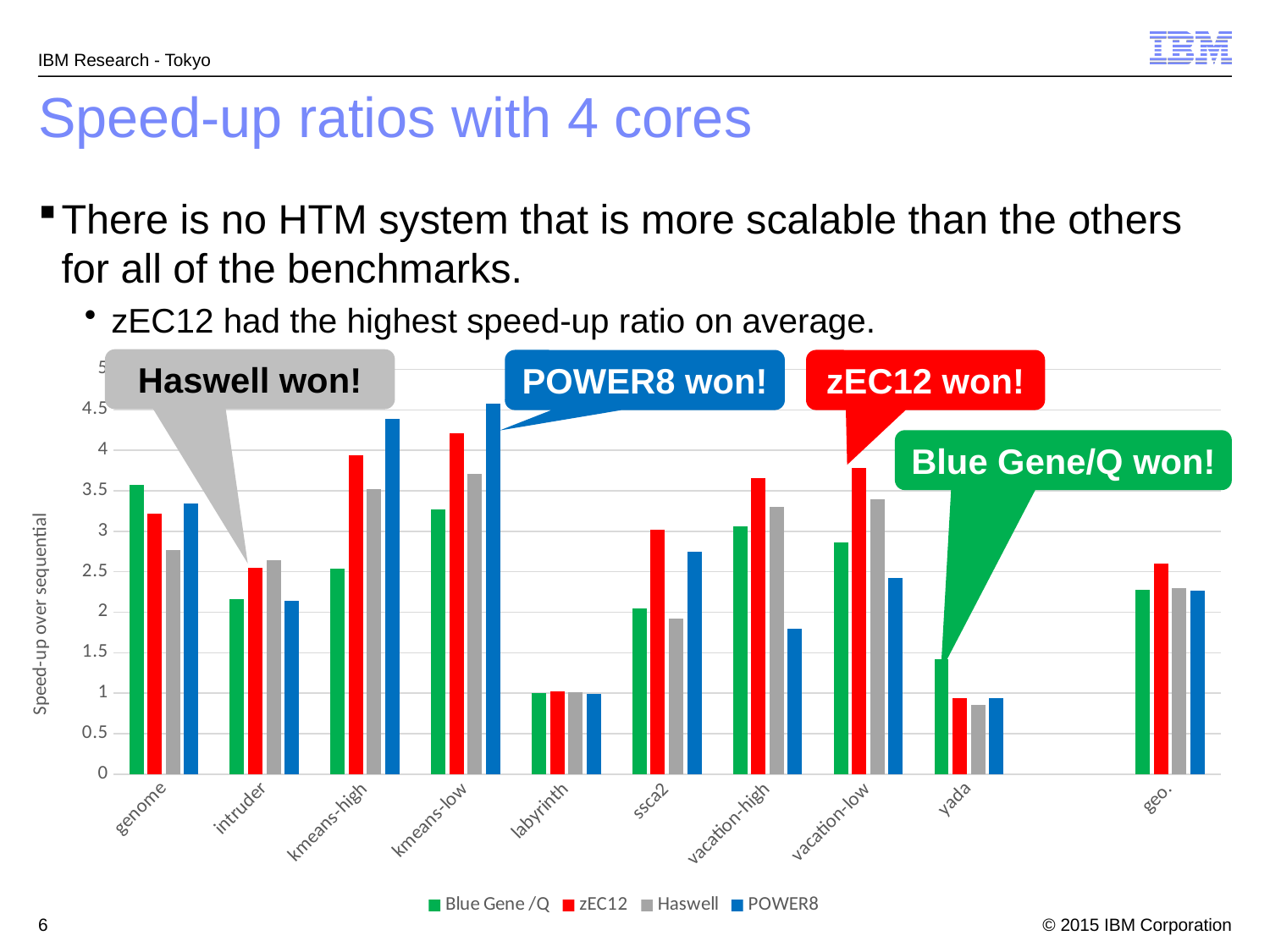
Which series has the highest speed-up for the yada benchmark? Blue Gene /Q Which series has the lowest speed-up for the vacation-high benchmark? POWER8 Is the zEC12 value for vacation-low greater or less than 3.5? greater How many benchmark categories are shown along the x axis of the chart? 10 What kind of chart is shown on the slide? bar chart Which series has the highest speed-up for the vacation-low benchmark? zEC12 What is the label on the vertical axis of the chart? Speed-up over sequential Is the Haswell value for ssca2 greater or less than 2? less Which series has the highest speed-up for the kmeans-low benchmark? POWER8 For the genome benchmark, which is larger: the zEC12 value or the Haswell value? zEC12 Is the POWER8 value for kmeans-low greater or less than 4? greater How many series does the chart legend list? 4